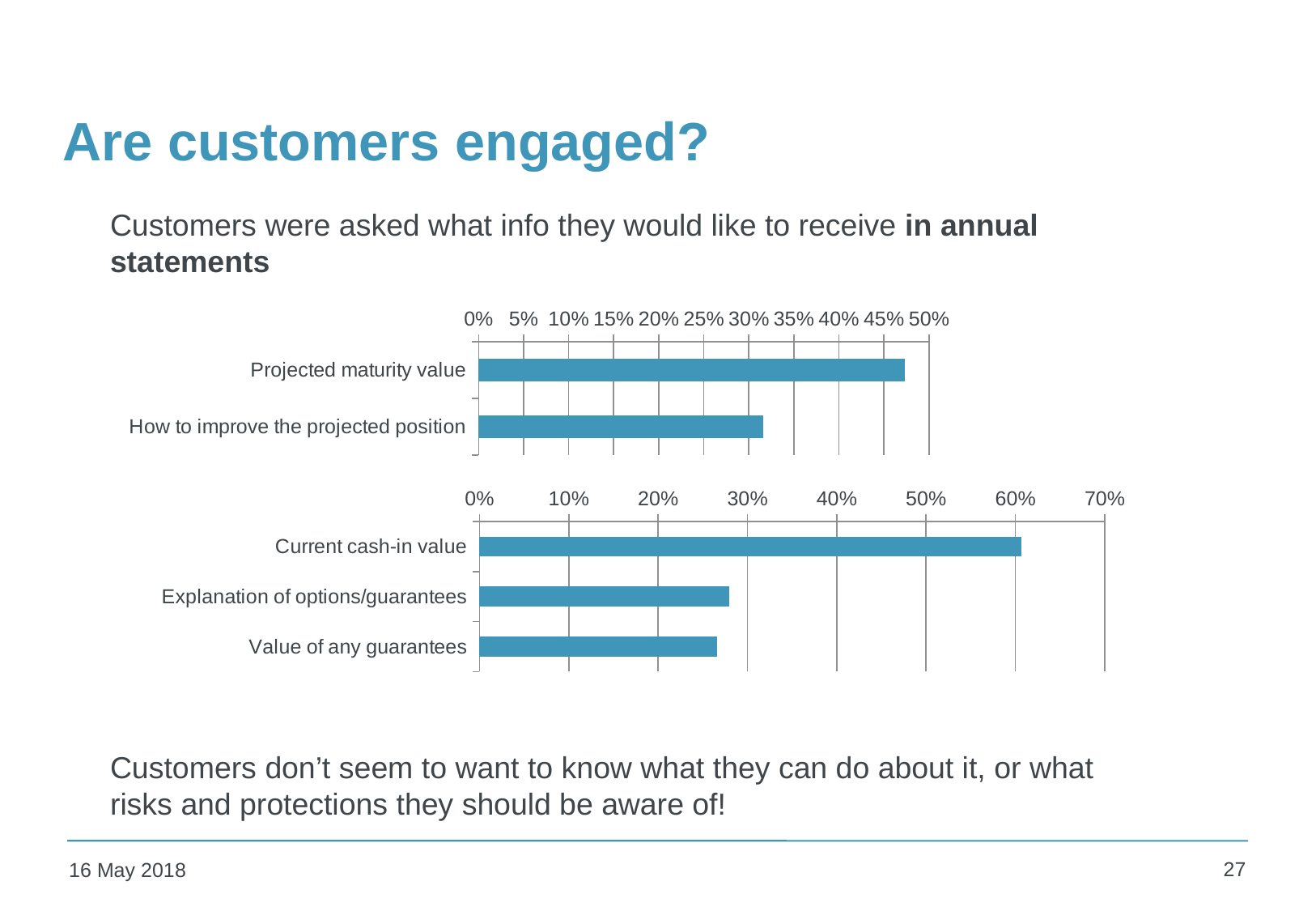
What kind of chart is the top chart on the slide? bar chart In the top chart, which category has the highest value? Projected maturity value In the top chart, is the value for How to improve the projected position greater or less than 35%? less In the bottom chart, is the value for Value of any guarantees greater or less than 20%? greater In the bottom chart, which category has the highest value? Current cash-in value How many categories does the bottom chart show? 3 How many categories does the top chart show? 2 In the bottom chart, which is larger: Current cash-in value or Explanation of options/guarantees? Current cash-in value In the top chart, is the value for Projected maturity value greater or less than 40%? greater What is the highest tick value shown on the x axis of the bottom chart? 70%